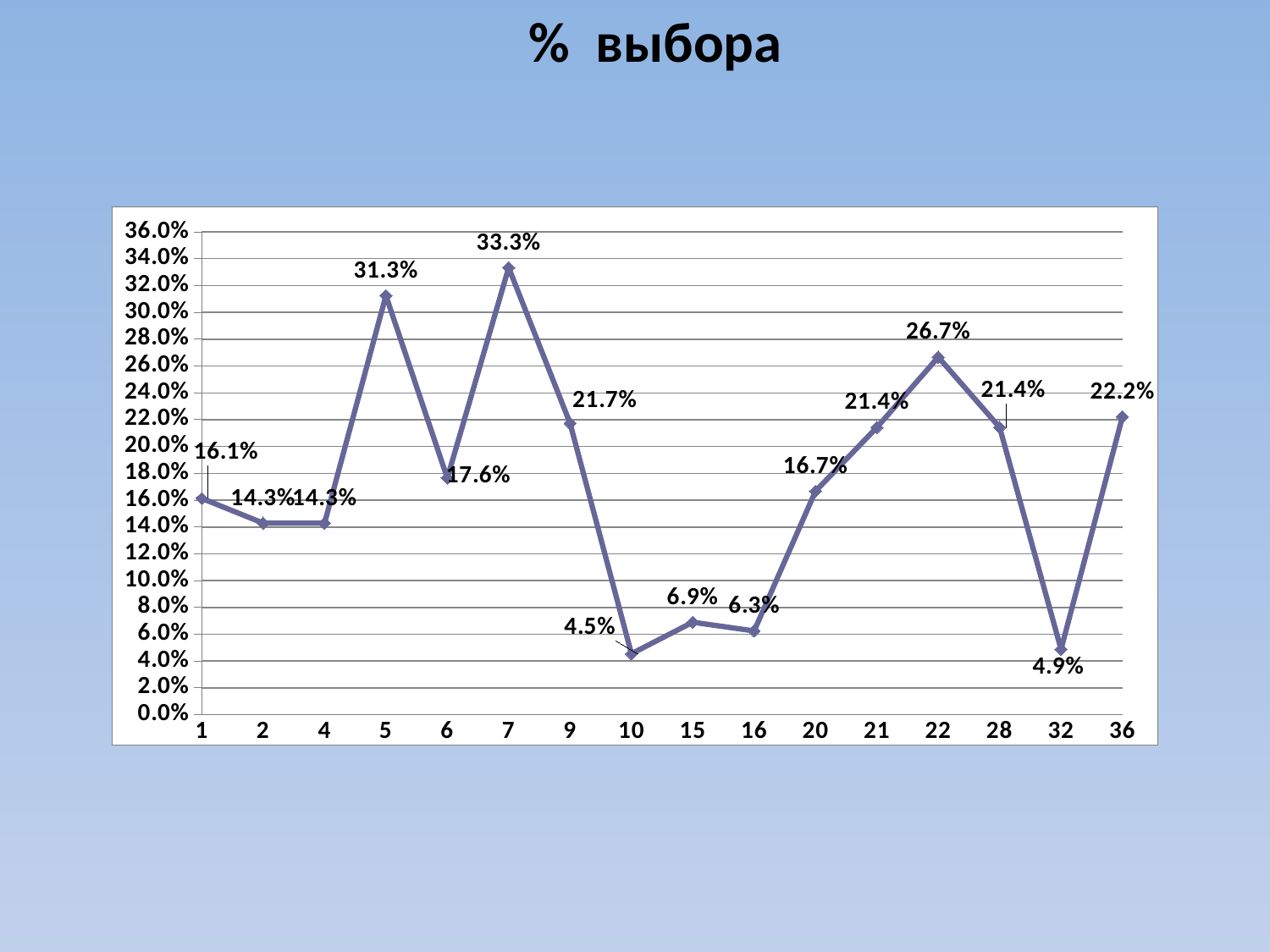
Is the value for category 20 greater or less than 10.0%? greater What is the value for category 7? 33.3% What is the difference between the values for category 5 and category 6? 13.7% How many data points are plotted on the chart? 16 Which category has the highest value? 7 What type of chart is shown on the slide? line chart What is the value for category 32? 4.9% Which has a larger value, category 9 or category 36? 36 What is the value for category 22? 26.7% Does the line rise or fall from category 22 to category 32? fall Which category has the lowest value? 10 What is the title of the chart? % выбора